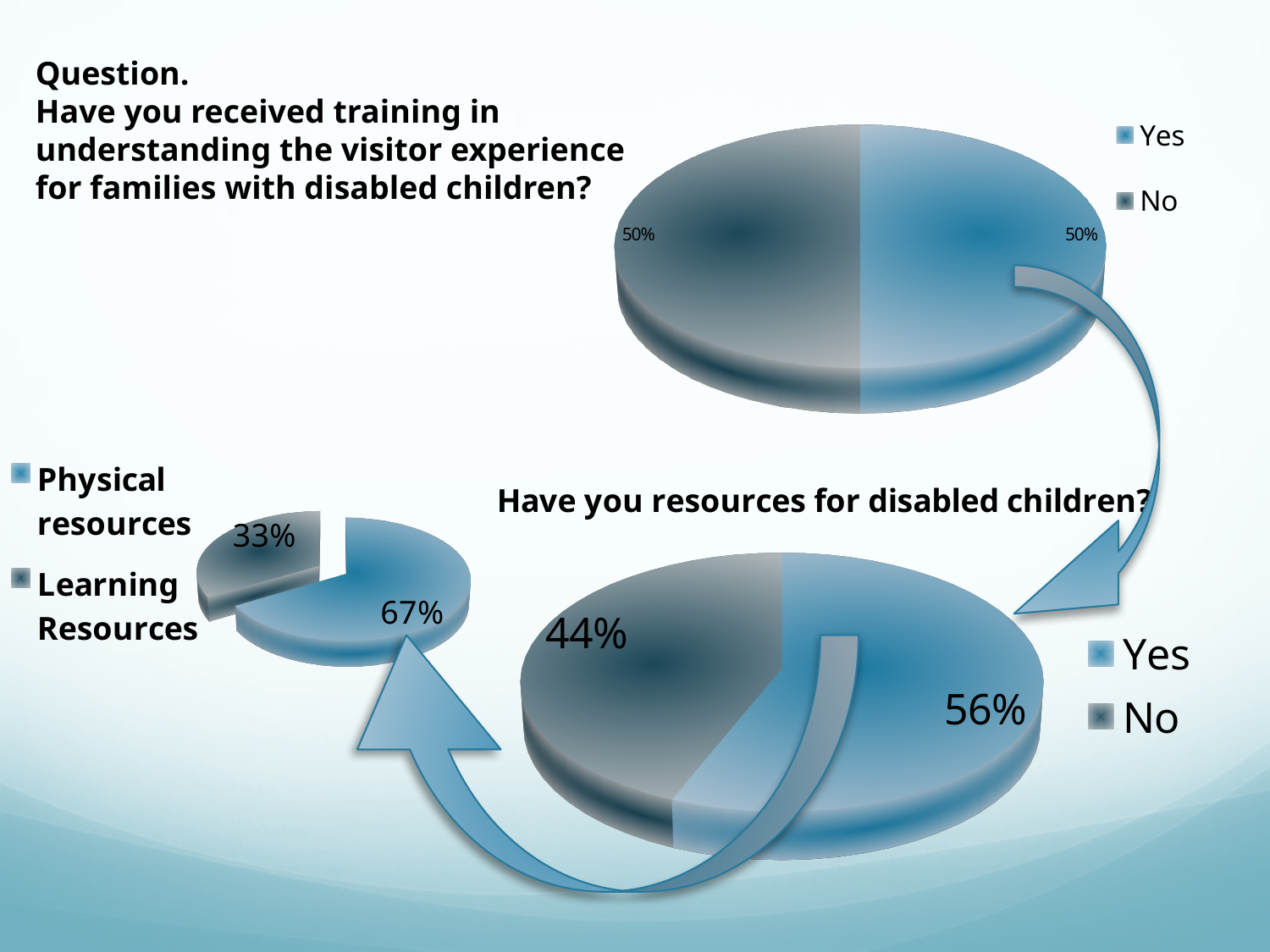
In the pie chart titled 'Have you resources for disabled children?', which answer has the larger share? Yes In the top-right pie chart about training in understanding the visitor experience, what share of respondents answered Yes? 50% In the bottom-left pie chart, what share is labelled for Learning Resources? 33% In the bottom-left pie chart, what share is labelled for Physical resources? 67% In the top-right pie chart about training in understanding the visitor experience, what share of respondents answered No? 50% What type of chart is used for the question 'Have you resources for disabled children?' Pie chart How many pie charts are shown on the slide? 3 In the pie chart titled 'Have you resources for disabled children?', what percentage answered Yes? 56% In the bottom-left pie chart, which category has the smaller share? Learning Resources In the bottom-left pie chart, how many categories does the legend list? 2 In the pie chart titled 'Have you resources for disabled children?', what is the difference between the Yes and No shares? 12% In the pie chart titled 'Have you resources for disabled children?', what percentage answered No? 44%